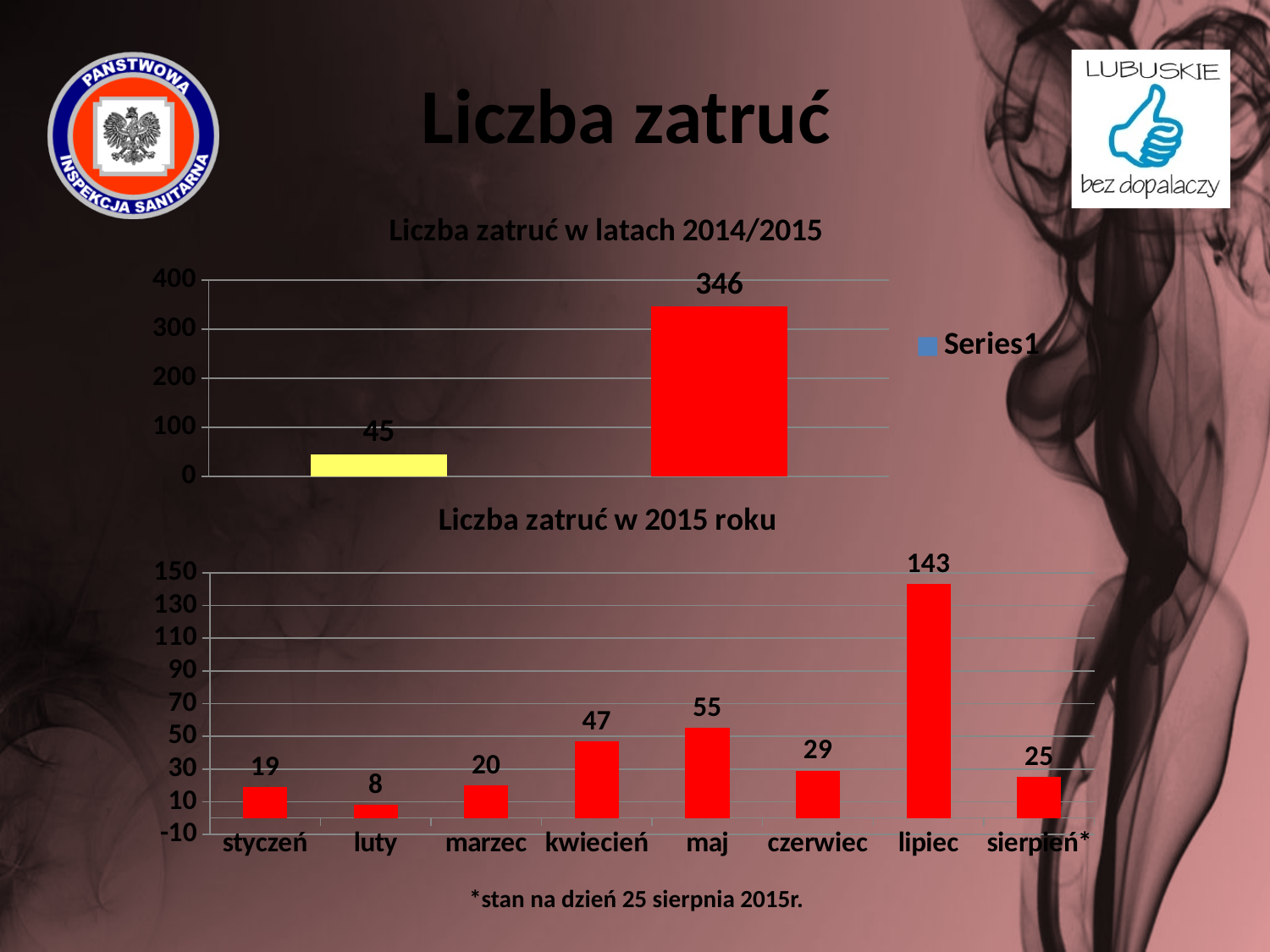
In the chart 'Liczba zatruć w 2015 roku', which is larger, the value for styczeń or the value for marzec? marzec What kind of chart is 'Liczba zatruć w 2015 roku'? bar chart In the chart 'Liczba zatruć w 2015 roku', what is the value for kwiecień? 47 In the chart 'Liczba zatruć w 2015 roku', what is the value for lipiec? 143 In the chart 'Liczba zatruć w 2015 roku', what is the value for luty? 8 In the chart 'Liczba zatruć w 2015 roku', which month has the highest value? lipiec In the chart 'Liczba zatruć w 2015 roku', which month has the lowest value? luty In the chart 'Liczba zatruć w latach 2014/2015', how many bars are plotted? 2 In the chart 'Liczba zatruć w latach 2014/2015', what is the difference between the two bars? 301 In the chart 'Liczba zatruć w 2015 roku', what is the difference between the values for maj and czerwiec? 26 In the chart 'Liczba zatruć w latach 2014/2015', what is the highest value shown? 346 In the chart 'Liczba zatruć w 2015 roku', how many months are shown on the x axis? 8